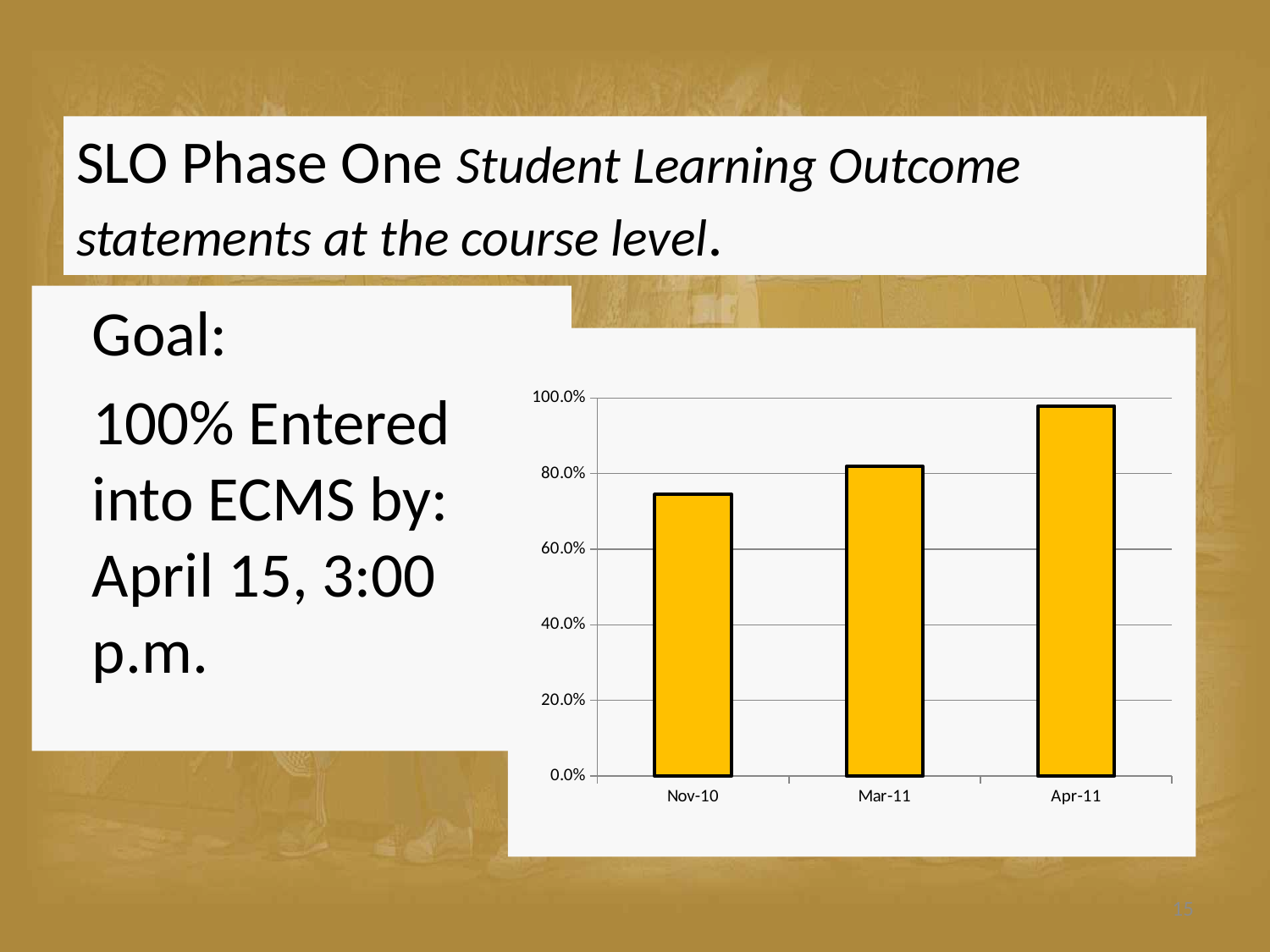
What kind of chart is shown on the slide? bar chart Do the values rise or fall from Nov-10 to Apr-11 along the x axis? rise Is the value for Mar-11 greater or less than 60.0%? greater Is the value for Apr-11 greater or less than 80.0%? greater Which is larger, the value for Apr-11 or the value for Mar-11? Apr-11 Is the value for Nov-10 greater or less than 60.0%? greater Which category has the lowest value in the chart? Nov-10 Which category has the highest value in the chart? Apr-11 What colour are the bars in the chart? yellow How many bars are plotted in the chart? 3 Which is larger, the value for Mar-11 or the value for Nov-10? Mar-11